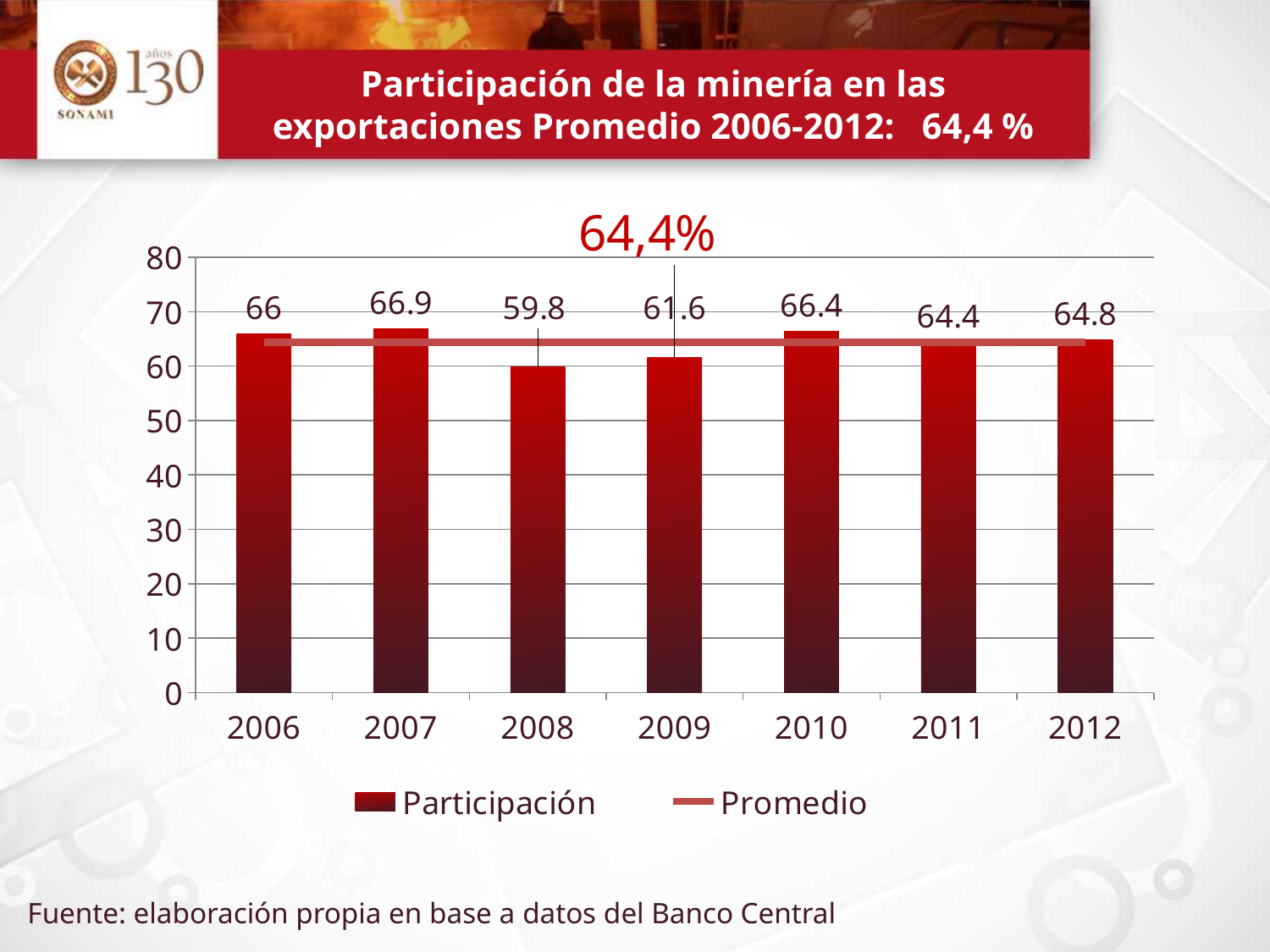
What value is labelled for the Promedio line? 64,4% What are the two series named in the legend? Participación and Promedio How many years are shown on the x axis? 7 Which year has the highest Participación value? 2007 How many series does the legend list? 2 Is the Participación value for 2008 greater or less than 60? less Which year has the lowest Participación value? 2008 What kind of chart is shown on the slide? combination bar and line chart Which is larger, the Participación value for 2006 or for 2009? 2006 What is the difference between the Participación values for 2007 and 2008? 7.1 What is the Participación value for 2008? 59.8 What is the Participación value for 2012? 64.8